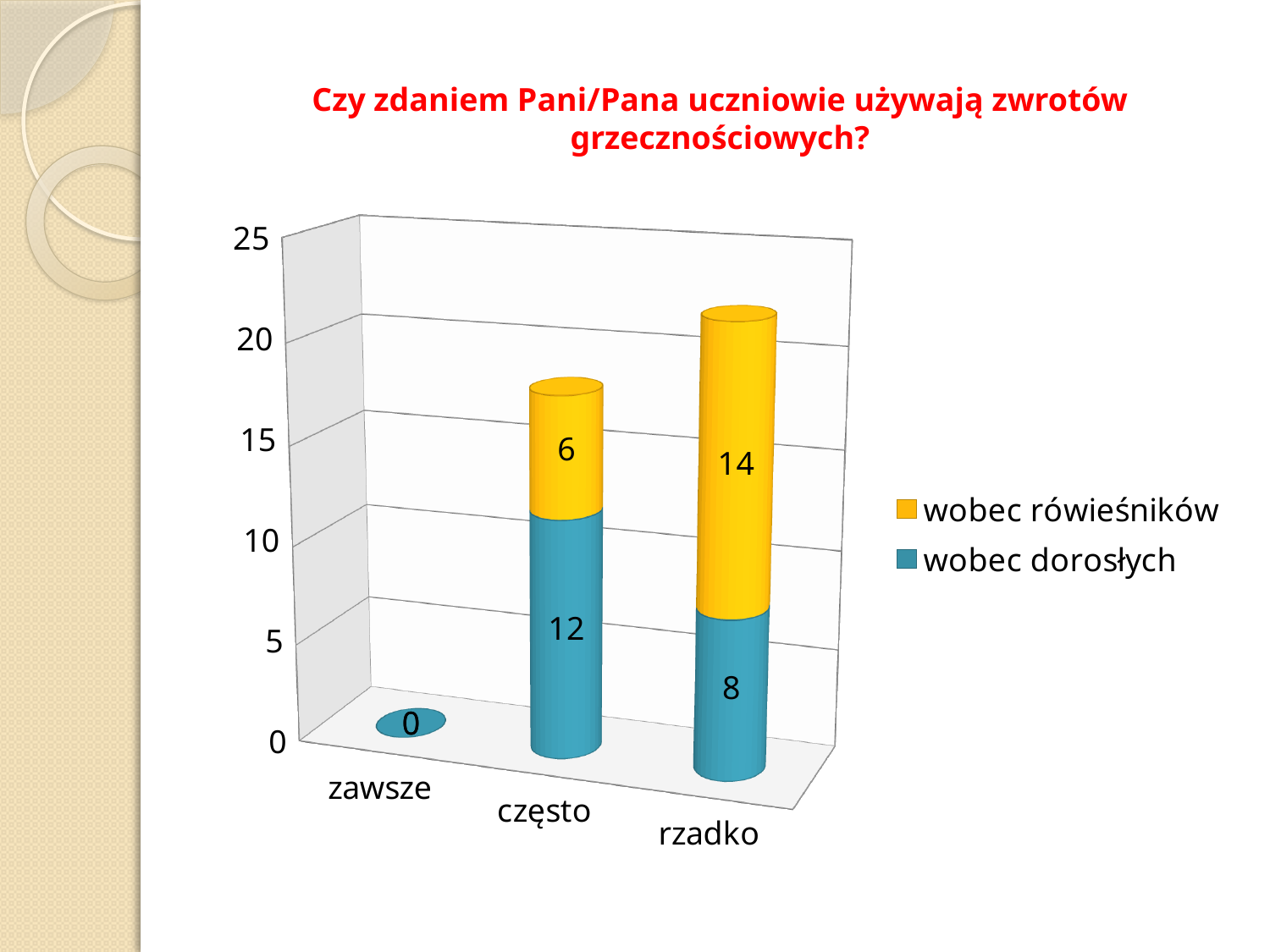
What is the difference between the "wobec rówieśników" values for "rzadko" and "często"? 8 How many series does the legend list? 2 Which is larger: "wobec dorosłych" for "często" or "wobec dorosłych" for "rzadko"? często How many categories are shown on the x axis? 3 What is the total of the stacked bar for "często"? 18 What is the value for "wobec dorosłych" in the "często" category? 12 Which category has the lowest value for "wobec dorosłych"? zawsze What is the value for "wobec dorosłych" in the "zawsze" category? 0 What is the total of the stacked bar for "rzadko"? 22 What is the value for "wobec rówieśników" in the "rzadko" category? 14 Which category has the highest value for "wobec dorosłych"? często What is the value for "wobec rówieśników" in the "często" category? 6